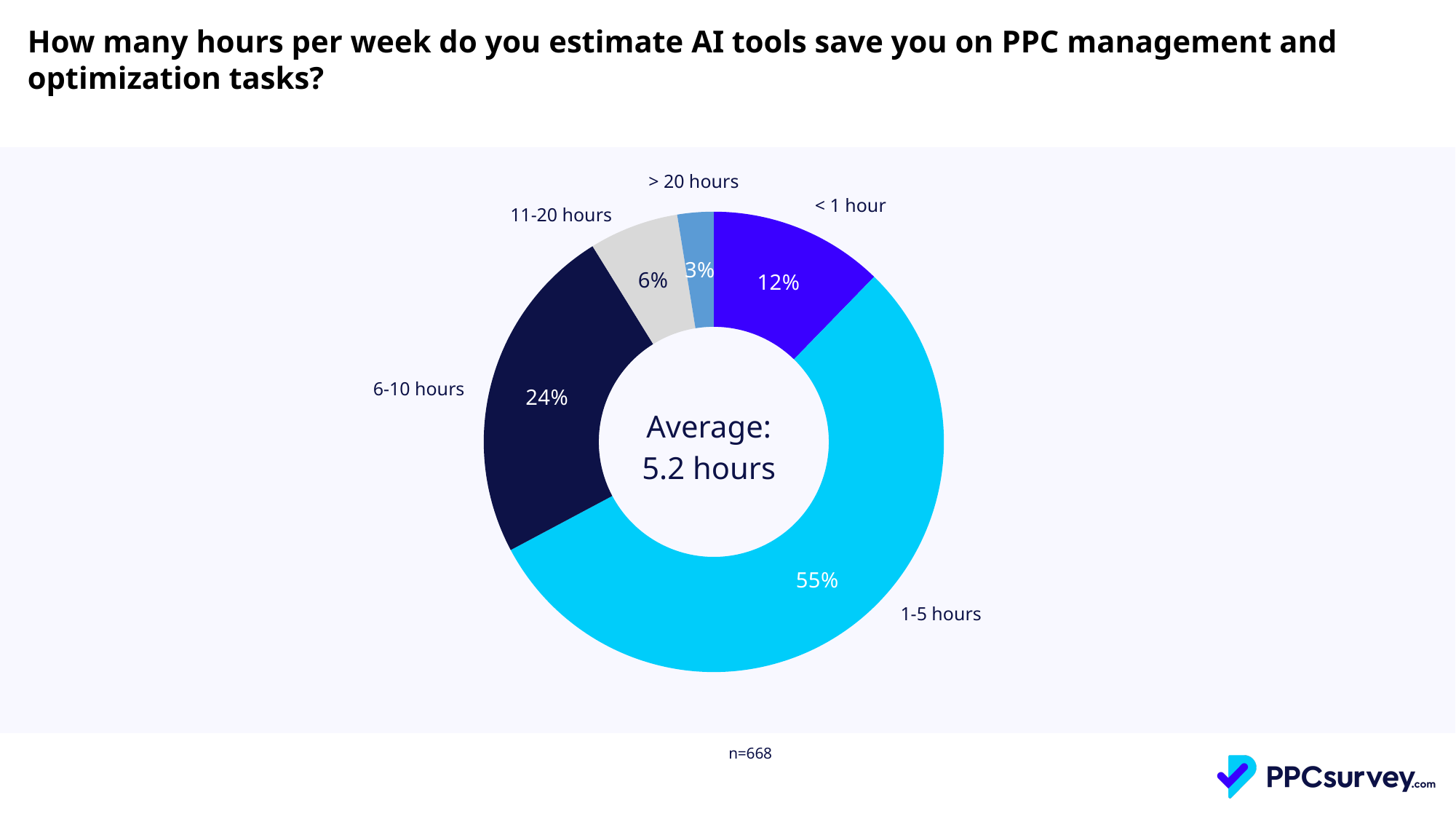
What percentage of respondents estimate AI tools save them 6-10 hours per week? 24% What percentage of respondents estimate AI tools save them 11-20 hours per week? 6% What kind of chart is shown on the slide? Pie chart (donut) What percentage of respondents estimate AI tools save them 1-5 hours per week? 55% Which category has the smallest share of respondents? > 20 hours What average number of hours saved per week is shown in the centre of the chart? 5.2 hours Which category has the largest share of respondents? 1-5 hours What percentage of respondents estimate AI tools save them less than 1 hour per week? 12% How many categories are shown in the chart? 5 What is the difference in percentage points between the 1-5 hours and 6-10 hours categories? 31 What percentage of respondents estimate AI tools save them more than 20 hours per week? 3% Which category has a larger share: < 1 hour or 11-20 hours? < 1 hour